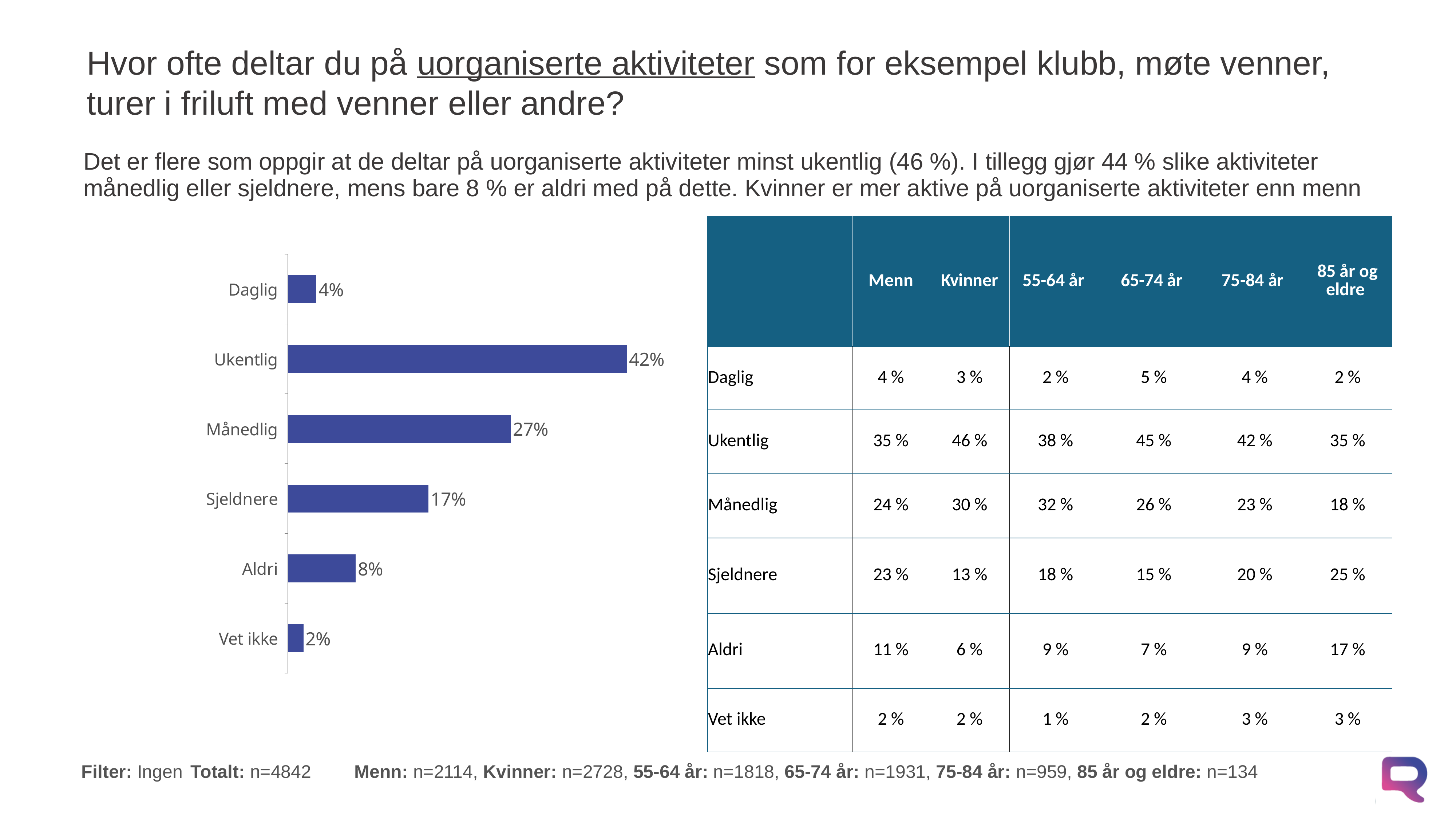
Which is larger in the bar chart, the value for Daglig or the value for Aldri? Aldri What is the value for Ukentlig in the bar chart? 42% What is the value for Daglig in the bar chart? 4% What is the value for Månedlig in the bar chart? 27% What is the difference between the values for Ukentlig and Månedlig in the bar chart? 15% Which category has the highest value in the bar chart? Ukentlig Which category has the lowest value in the bar chart? Vet ikke What is the difference between the values for Sjeldnere and Aldri in the bar chart? 9% What kind of chart is shown on the left of the slide? Bar chart What is the value for Aldri in the bar chart? 8% What is the value for Sjeldnere in the bar chart? 17% How many categories are shown in the bar chart? 6